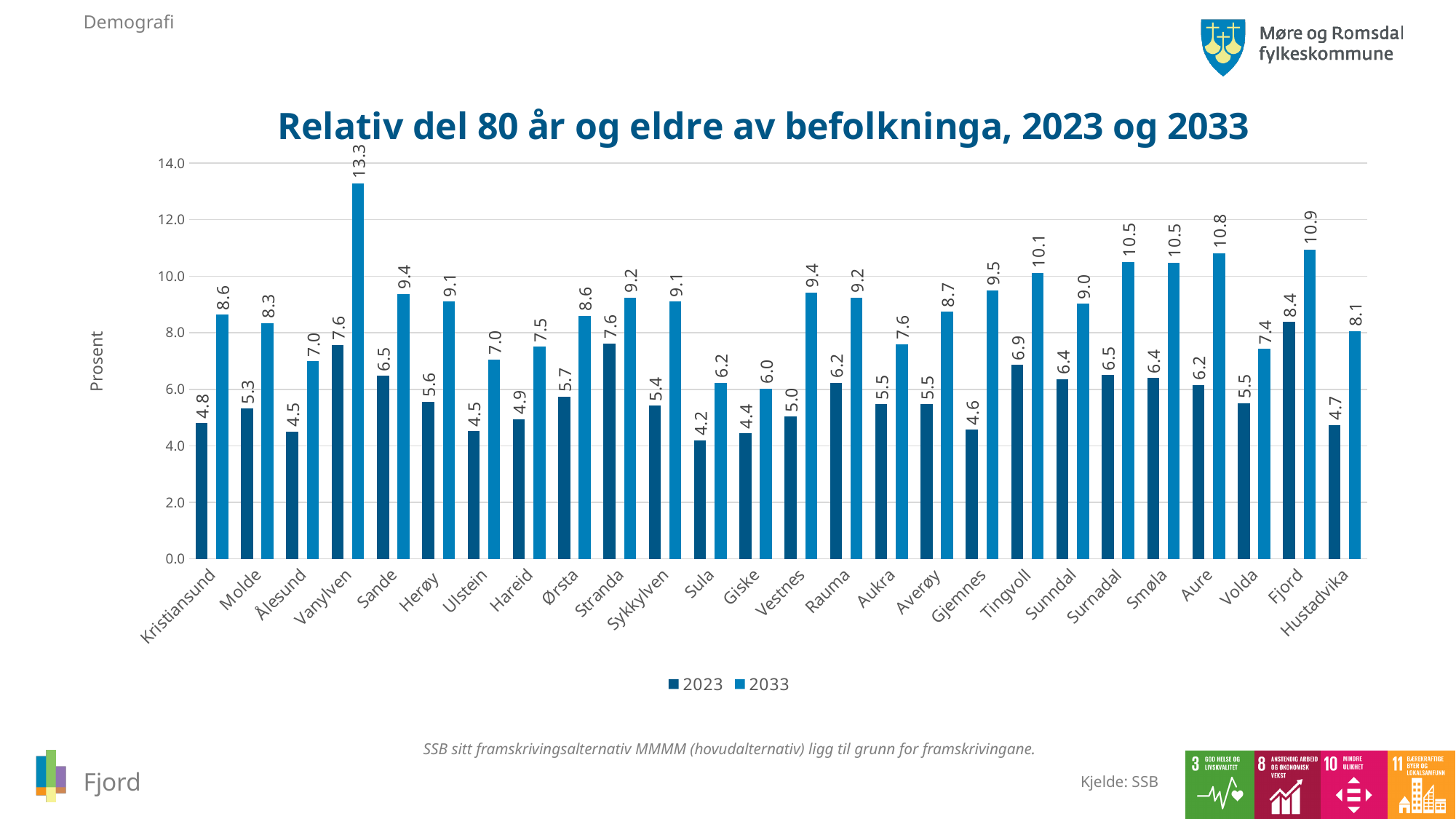
How many municipalities are shown on the x axis? 26 What is the label of the y axis? Prosent Which is larger: the 2033 value for Aure or the 2033 value for Tingvoll? Aure What kind of chart is shown on the slide? Bar chart Which municipality has the lowest value in the 2033 series? Giske Which municipality has the lowest value in the 2023 series? Sula Which municipality has the highest value in the 2033 series? Vanylven What is the value for Gjemnes in the 2033 series? 9.5 What is the value for Vanylven in the 2033 series? 13.3 How many series does the legend list? 2 What is the difference between the 2033 and 2023 values for Vanylven? 5.7 What is the value for Fjord in the 2023 series? 8.4